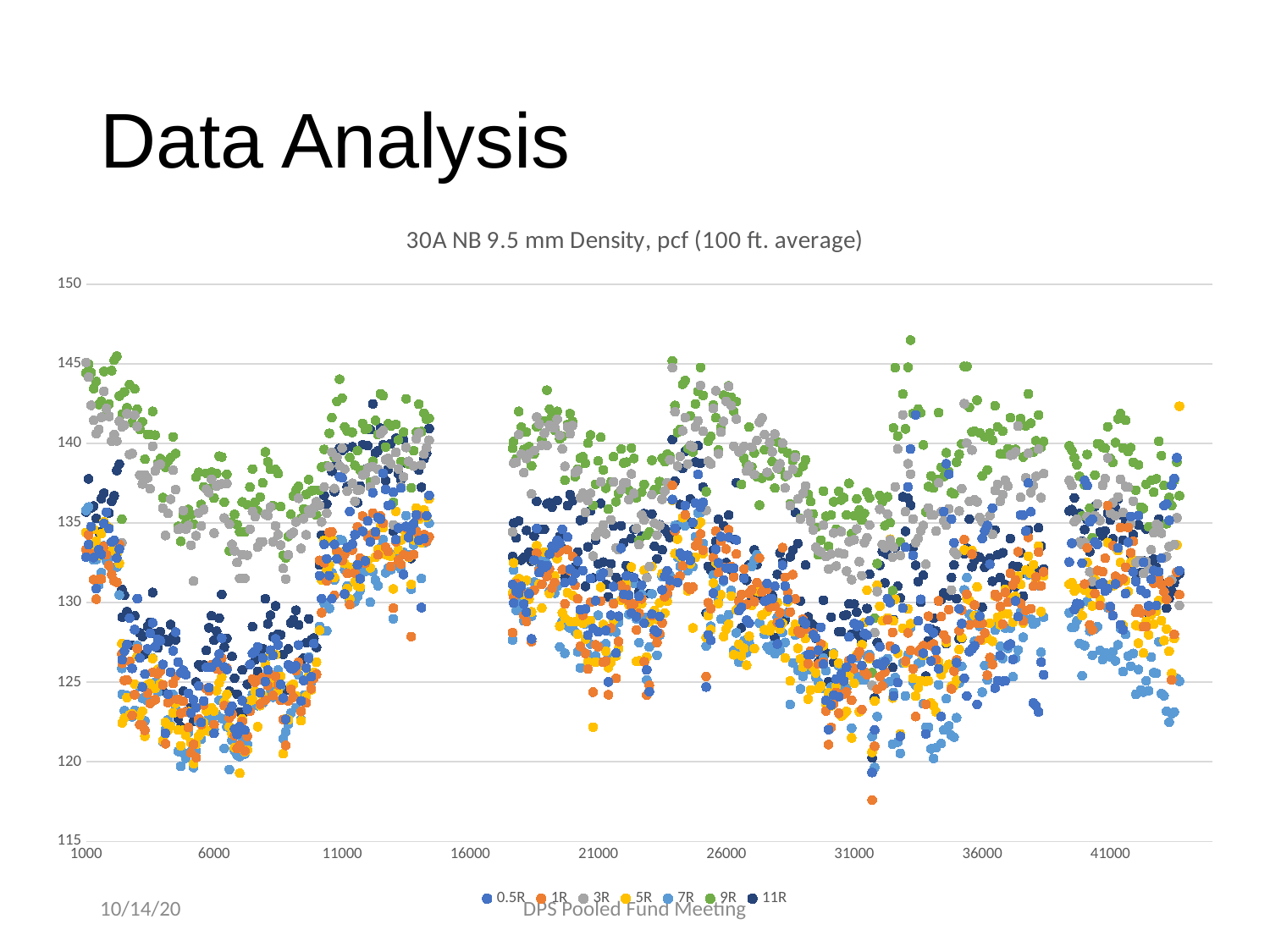
What is the title of the chart? 30A NB 9.5 mm Density, pcf (100 ft. average) Which series has higher values overall, 3R or 1R? 3R Which series is plotted in green? 9R Are the values for the 9R series greater or less than 130? greater Which series has the highest density values overall across the chart? 9R What kind of chart is shown on the slide? Scatter chart What is the maximum value shown on the vertical axis? 150 How many series does the legend list? 7 Which series has higher values overall, 9R or 5R? 9R Is the lowest plotted point on the chart greater or less than 120? less